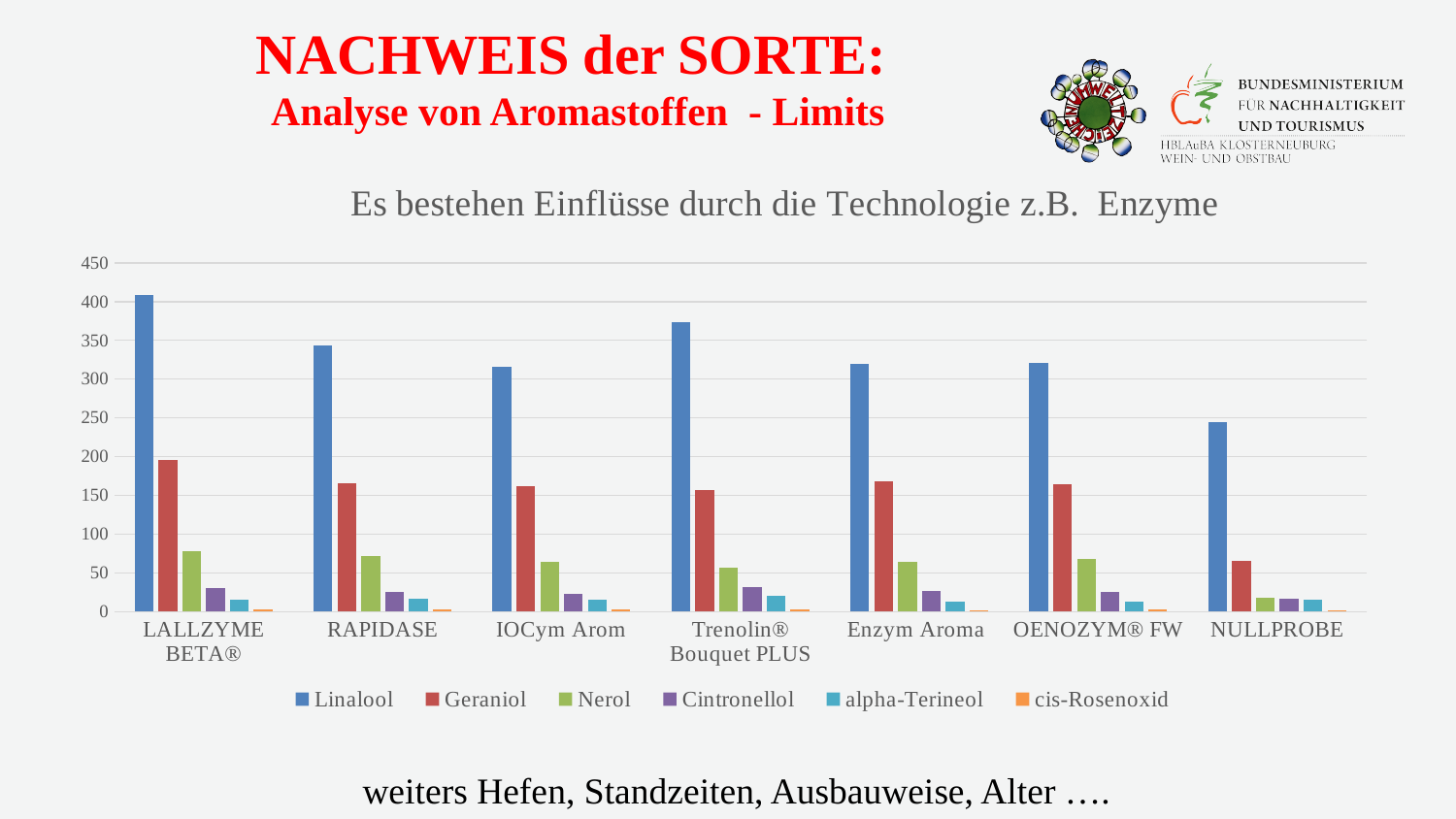
How many enzyme categories are shown on the x axis of the chart? 7 Which is larger: the Linalool value for LALLZYME BETA® or for RAPIDASE? LALLZYME BETA® Is the Linalool value for Trenolin® Bouquet PLUS greater or less than 350? greater Is the Nerol value for NULLPROBE greater or less than 50? less Is the Linalool value for NULLPROBE greater or less than 300? less Which category has the lowest Linalool value? NULLPROBE Which category has the lowest Geraniol value? NULLPROBE Which colour represents Linalool in the chart legend? blue Which category has the highest Linalool value? LALLZYME BETA® How many series does the chart legend list? 6 What kind of chart is shown on the slide? bar chart